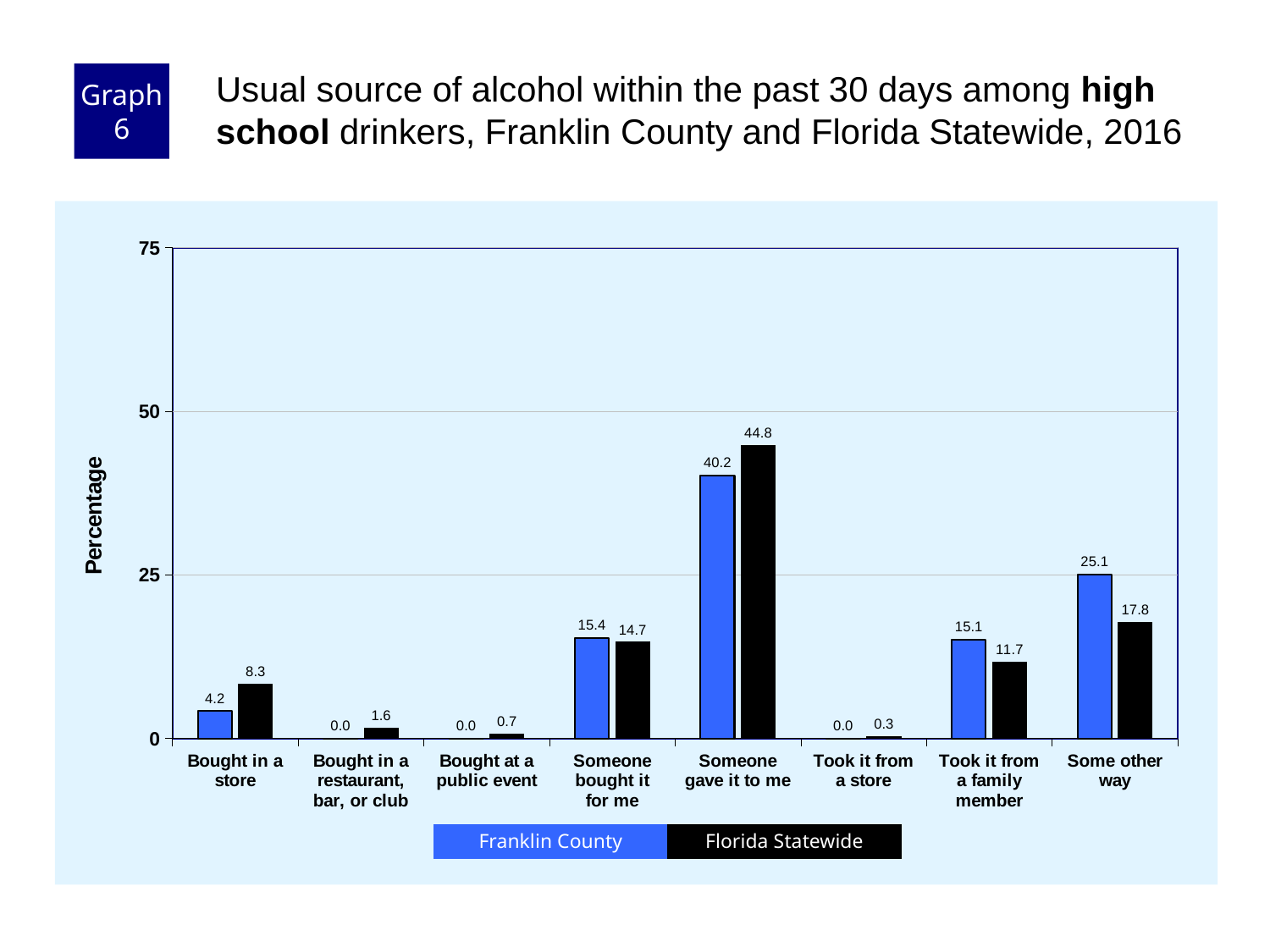
For "Took it from a family member", which is larger: Franklin County or Florida Statewide? Franklin County How many source categories are shown on the x axis? 8 What is the Franklin County value for "Took it from a family member"? 15.1 What kind of chart is shown on the slide? bar chart What is the difference between the Florida Statewide and Franklin County values for "Someone gave it to me"? 4.6 Which category has the lowest Florida Statewide value? Took it from a store Is the Franklin County value for "Some other way" greater or less than 25? greater What is the Franklin County value for "Someone gave it to me"? 40.2 Which category has the highest Florida Statewide value? Someone gave it to me What is the Florida Statewide value for "Bought in a store"? 8.3 How many series does the legend list? 2 What is the difference between the Franklin County and Florida Statewide values for "Some other way"? 7.3